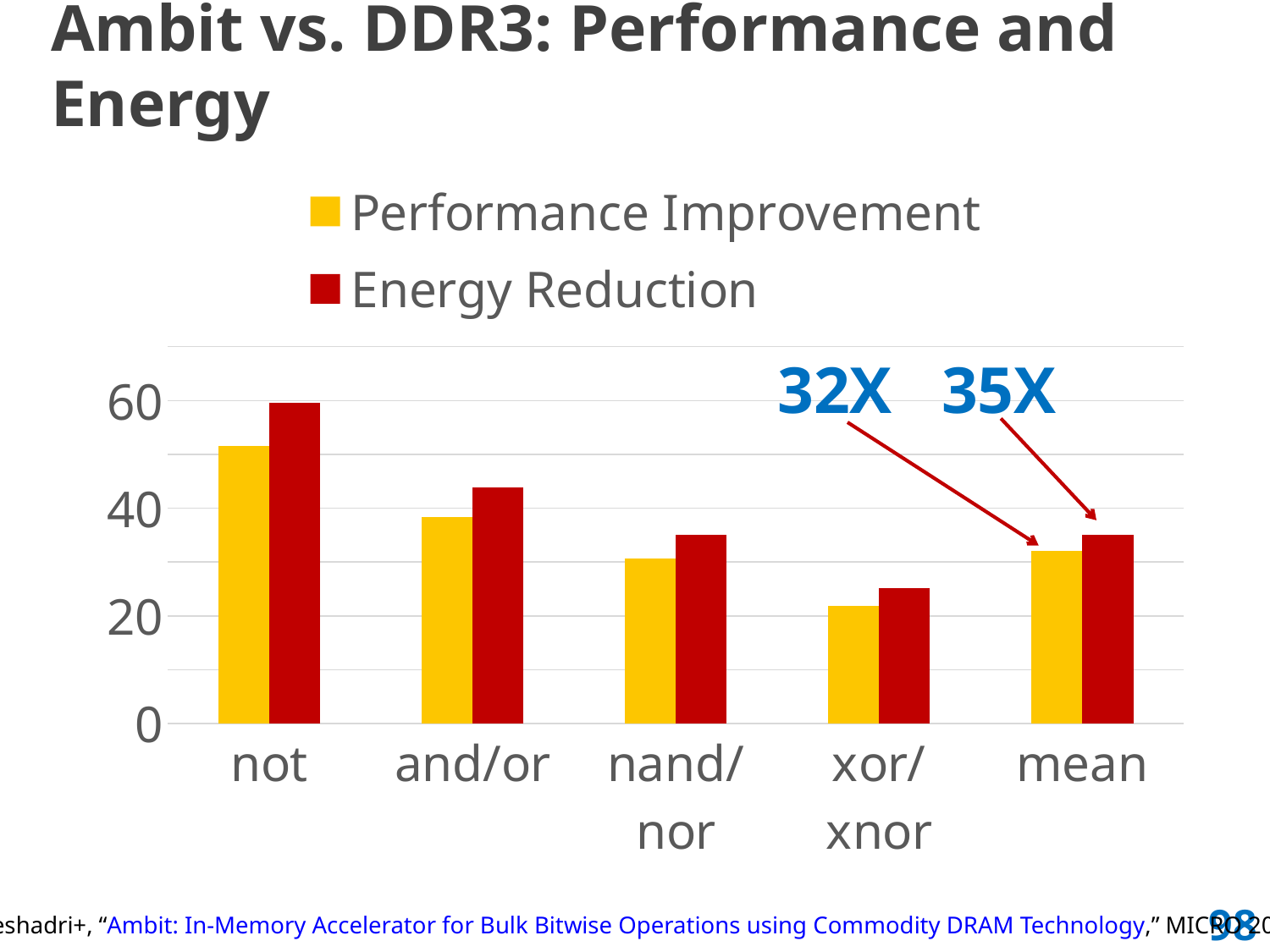
Which category has the lowest Performance Improvement? xor/xnor What is the Energy Reduction value for mean? 35X How many series does the legend list? 2 Is the Energy Reduction value for xor/xnor greater or less than 40? less What kind of chart is shown on the slide? bar chart How many categories are shown on the x axis? 5 For the not category, which is larger: Performance Improvement or Energy Reduction? Energy Reduction What is the Performance Improvement value for mean? 32X Which colour represents Energy Reduction in the legend? red What is the difference between the Energy Reduction and Performance Improvement values for mean? 3X Is the Performance Improvement value for not greater or less than 40? greater Which category has the highest Energy Reduction? not